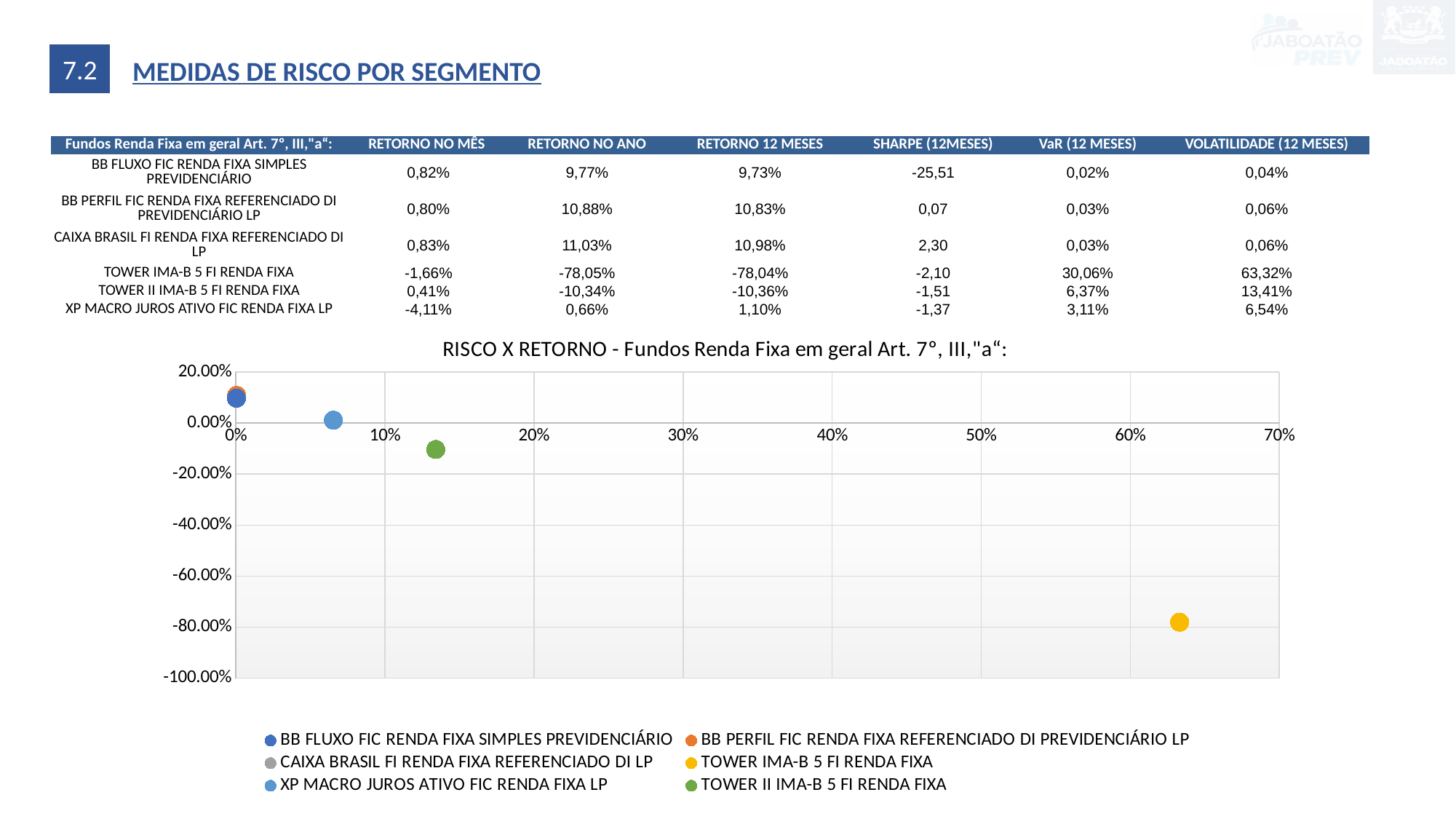
In the RISCO X RETORNO chart, which has the higher vertical-axis value: XP MACRO JUROS ATIVO FIC RENDA FIXA LP or TOWER II IMA-B 5 FI RENDA FIXA? XP MACRO JUROS ATIVO FIC RENDA FIXA LP What is the title of the chart on the slide? RISCO X RETORNO - Fundos Renda Fixa em geral Art. 7°, III,"a": How many series does the legend of the RISCO X RETORNO chart list? 6 In the RISCO X RETORNO chart, which fund has the lowest return (vertical axis)? TOWER IMA-B 5 FI RENDA FIXA In the RISCO X RETORNO chart, is the horizontal-axis value for TOWER II IMA-B 5 FI RENDA FIXA greater or less than 10%? greater In the RISCO X RETORNO chart, is the horizontal-axis value for TOWER IMA-B 5 FI RENDA FIXA greater or less than 60%? greater In the RISCO X RETORNO chart, is the vertical-axis value for TOWER II IMA-B 5 FI RENDA FIXA greater or less than 0.00%? less In the RISCO X RETORNO chart, which colour marks the TOWER IMA-B 5 FI RENDA FIXA series? Yellow What kind of chart is shown on the slide? Scatter chart In the RISCO X RETORNO chart, which is plotted further right on the horizontal axis: TOWER II IMA-B 5 FI RENDA FIXA or XP MACRO JUROS ATIVO FIC RENDA FIXA LP? TOWER II IMA-B 5 FI RENDA FIXA In the RISCO X RETORNO chart, which fund is plotted furthest to the right on the horizontal axis? TOWER IMA-B 5 FI RENDA FIXA